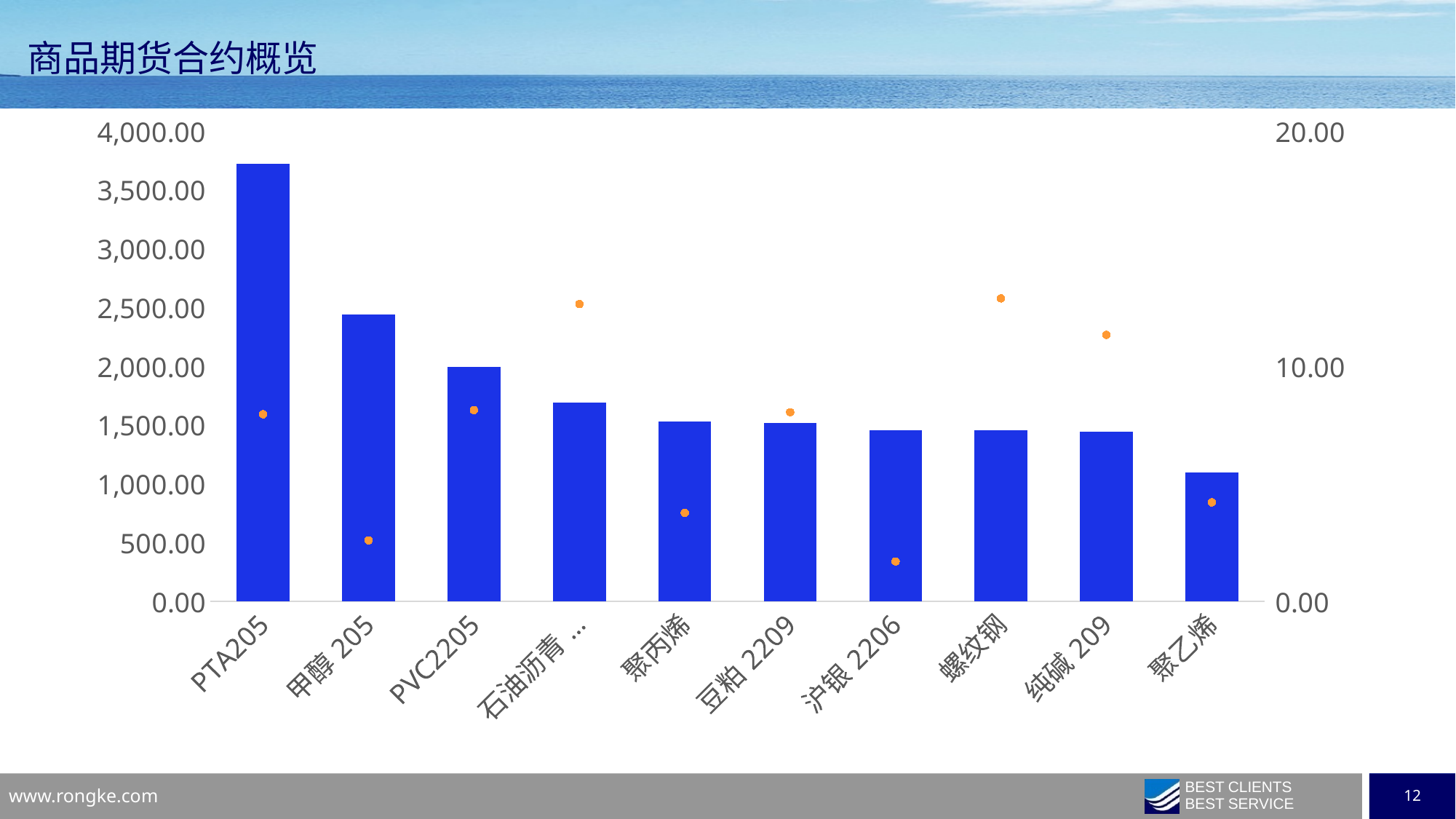
Is the blue bar for 聚丙烯 greater or less than 2,000.00? less Which has the taller blue bar, 甲醇 205 or PVC2205? 甲醇 205 What is the title of the slide containing the chart? 商品期货合约概览 Which category has the tallest blue bar? PTA205 Which category has the shortest blue bar? 聚乙烯 Is the blue bar for 甲醇 205 greater or less than 2,500.00? less Is the blue bar for PTA205 greater or less than 3,500.00? greater How many categories are shown on the x axis of the chart? 10 Do the blue bars generally rise or fall from left to right along the x axis? fall What kind of chart is shown on the slide? bar chart